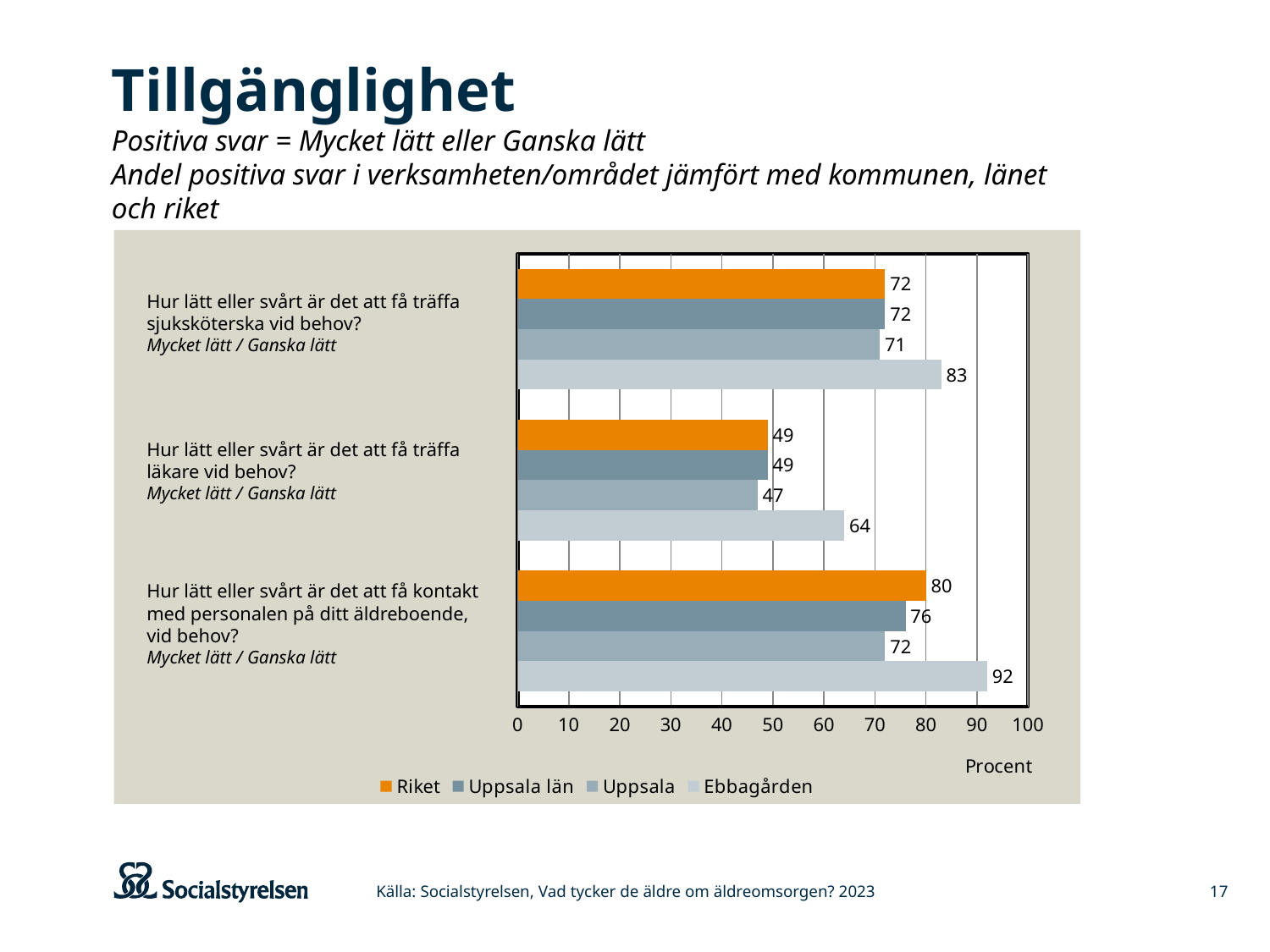
Which is larger for the question about getting in contact with staff at the care home: Riket or Uppsala län? Riket Which series has the lowest value for the question about getting in contact with staff at the care home? Uppsala How many series does the legend list? 4 Which series has the highest value for the question about meeting a doctor when needed? Ebbagården What is the value for Riket for the question about meeting a doctor when needed ("Hur lätt eller svårt är det att få träffa läkare vid behov?")? 49 What unit is shown on the x axis of the chart? Procent What kind of chart is shown on the slide? Bar chart How many question categories are plotted on the chart? 3 What is the difference between Ebbagården and Riket for the question about meeting a nurse when needed? 11 What is the value for Uppsala for the question about meeting a nurse when needed ("Hur lätt eller svårt är det att få träffa sjuksköterska vid behov?")? 71 What is the value for Ebbagården for the question about getting in contact with staff at the care home ("Hur lätt eller svårt är det att få kontakt med personalen på ditt äldreboende, vid behov?")? 92 Is the value for Ebbagården for the question about meeting a doctor when needed greater or less than 60? greater